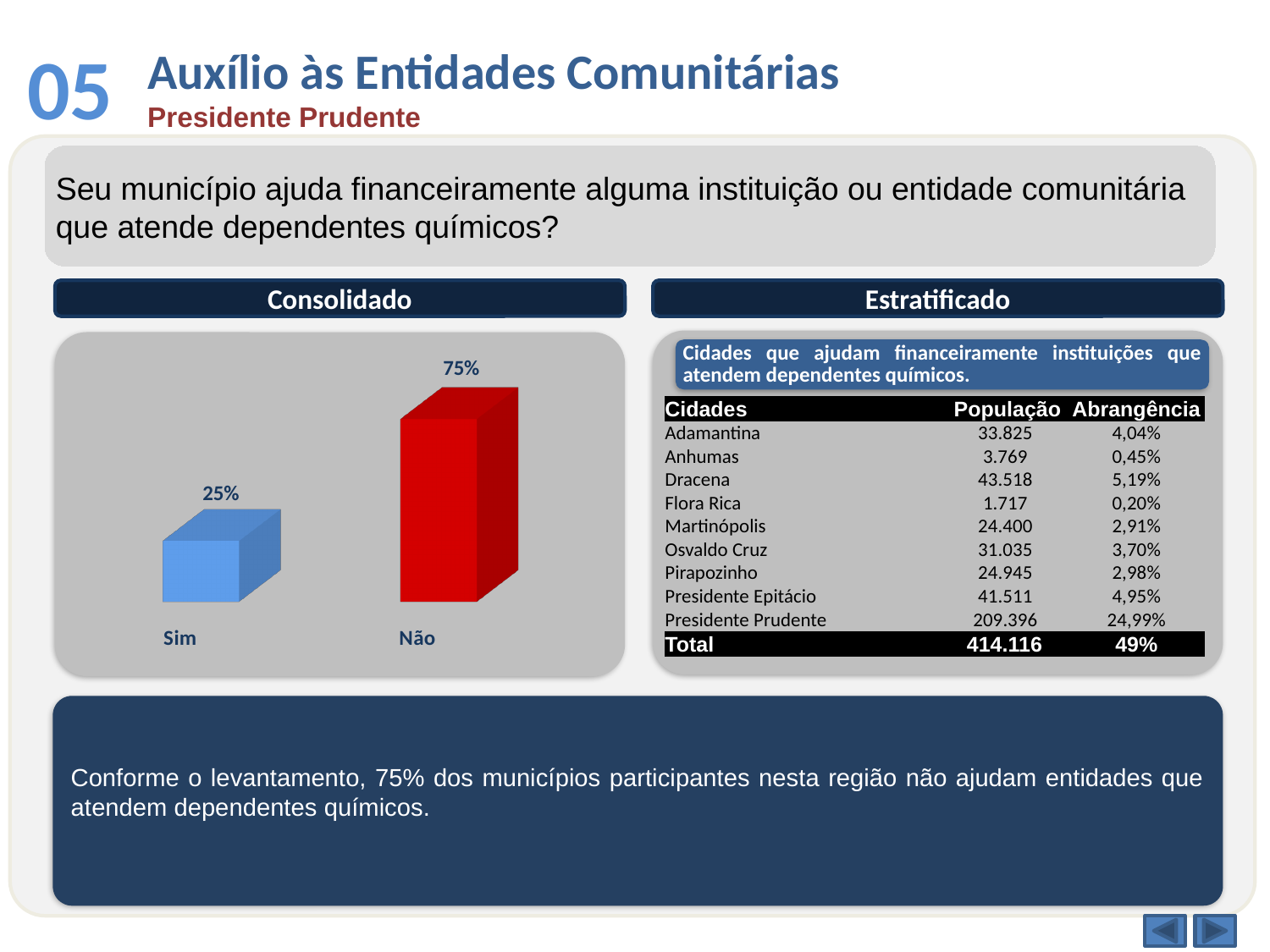
What colour is the bar for Sim in the Consolidado chart? Blue What is the total of the two values shown in the Consolidado chart? 100% What is the value for Sim in the Consolidado chart? 25% How many categories are shown in the Consolidado chart? 2 Which category has the lowest value in the Consolidado chart? Sim In the Consolidado chart, which is larger: the value for Sim or the value for Não? Não What is the value for Não in the Consolidado chart? 75% What is the difference between the values for Não and Sim in the Consolidado chart? 50% What kind of chart is the Consolidado chart? Bar chart Which category has the highest value in the Consolidado chart? Não What colour is the bar for Não in the Consolidado chart? Red